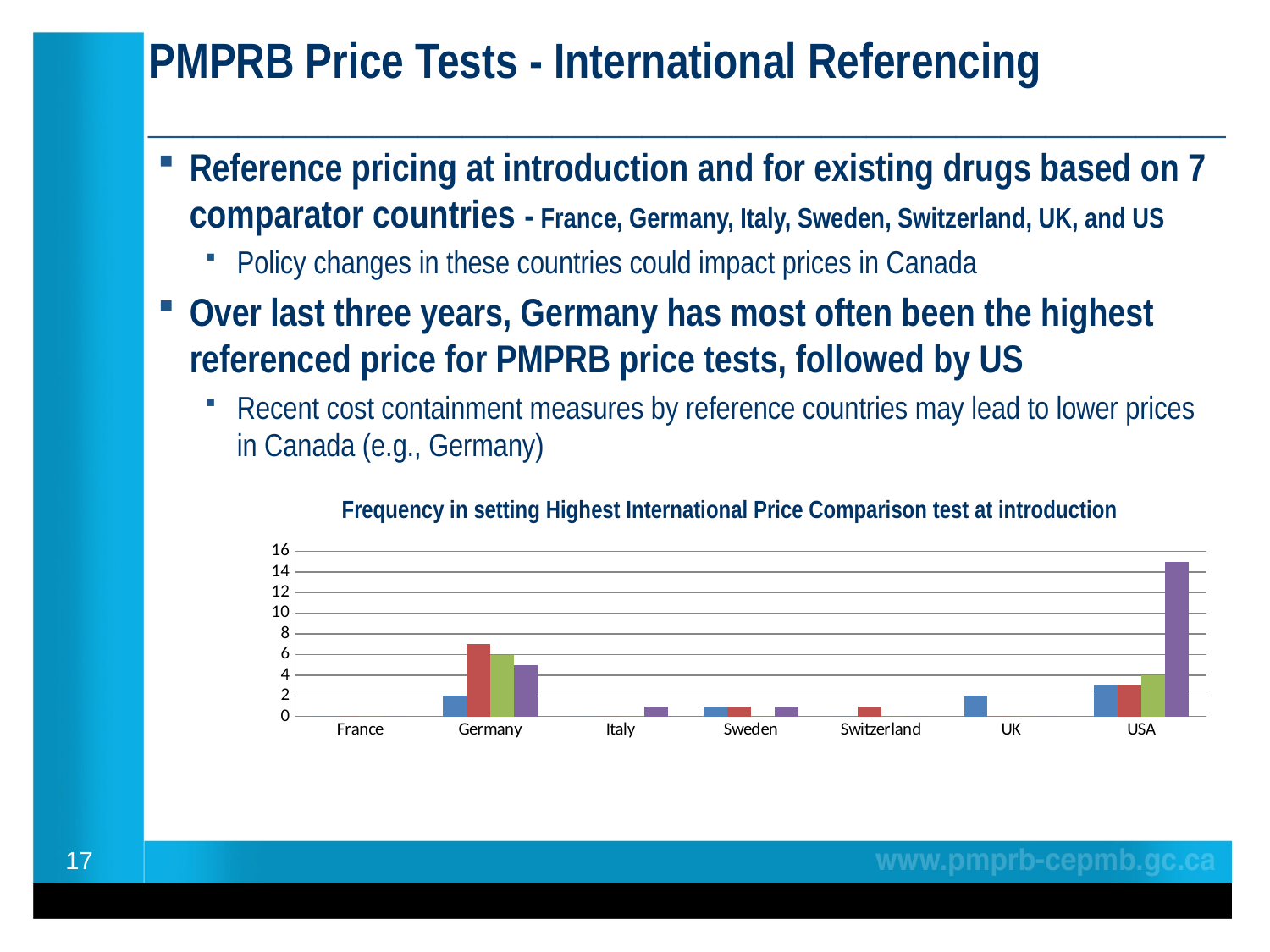
Which country has the tallest bar in the chart? USA How many countries are shown on the x axis of the chart? 7 What is the value of the green bar for USA? 4 Is the value of the red bar for Germany greater or less than 4? greater Is the value of the blue bar for Sweden greater or less than 2? less What kind of chart is shown on the slide? bar chart What is the title of the chart on the slide? Frequency in setting Highest International Price Comparison test at introduction Which country shows no bars at all in the chart? France Is the value of the purple bar for USA greater or less than 10? greater What is the value of the blue bar for UK? 2 Which is larger, the red bar for Germany or the red bar for USA? Germany What is the highest value shown on the vertical axis of the chart? 16